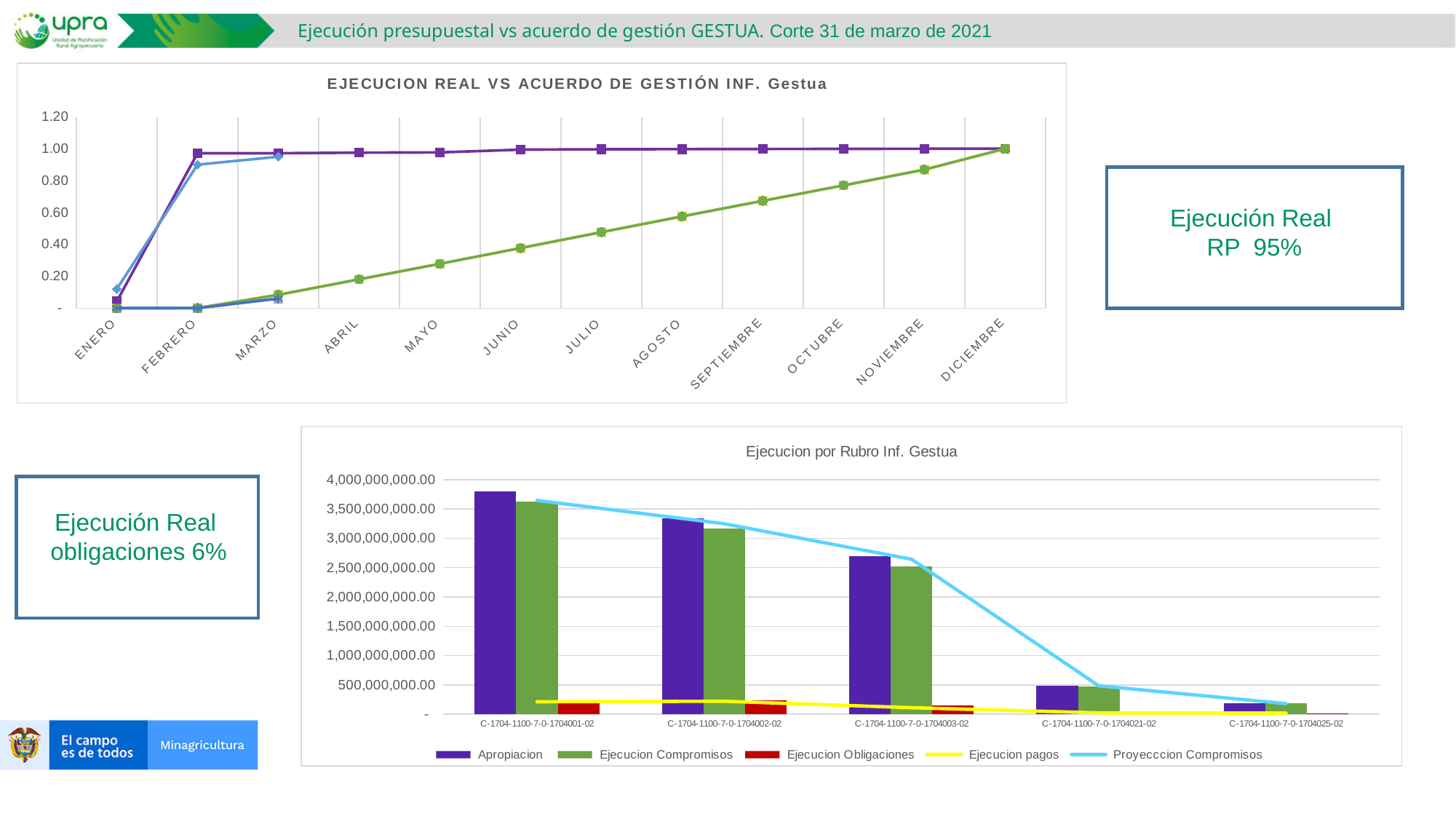
In the bottom chart 'Ejecucion por Rubro Inf. Gestua', which category has the highest Apropiacion? C-1704-1100-7-0-1704001-02 In the top chart 'EJECUCION REAL VS ACUERDO DE GESTIÓN INF. Gestua', does the green line rise or fall from ENERO to DICIEMBRE? rise In the bottom chart 'Ejecucion por Rubro Inf. Gestua', how many rubro categories are shown on the x axis? 5 In the bottom chart 'Ejecucion por Rubro Inf. Gestua', which category has the lowest Apropiacion? C-1704-1100-7-0-1704025-02 In the bottom chart 'Ejecucion por Rubro Inf. Gestua', is the Apropiacion for C-1704-1100-7-0-1704001-02 greater or less than 3,500,000,000.00? greater In the bottom chart 'Ejecucion por Rubro Inf. Gestua', which series is drawn as the light blue line? Proyecccion Compromisos In the top chart 'EJECUCION REAL VS ACUERDO DE GESTIÓN INF. Gestua', is the value of the green line for MAYO greater or less than 0.40? less In the bottom chart 'Ejecucion por Rubro Inf. Gestua', how many series does the legend list? 5 In the top chart 'EJECUCION REAL VS ACUERDO DE GESTIÓN INF. Gestua', is the value of the green line for SEPTIEMBRE greater or less than 0.60? greater In the top chart 'EJECUCION REAL VS ACUERDO DE GESTIÓN INF. Gestua', how many months are shown on the x axis? 12 What type of chart is the top chart titled 'EJECUCION REAL VS ACUERDO DE GESTIÓN INF. Gestua'? line chart